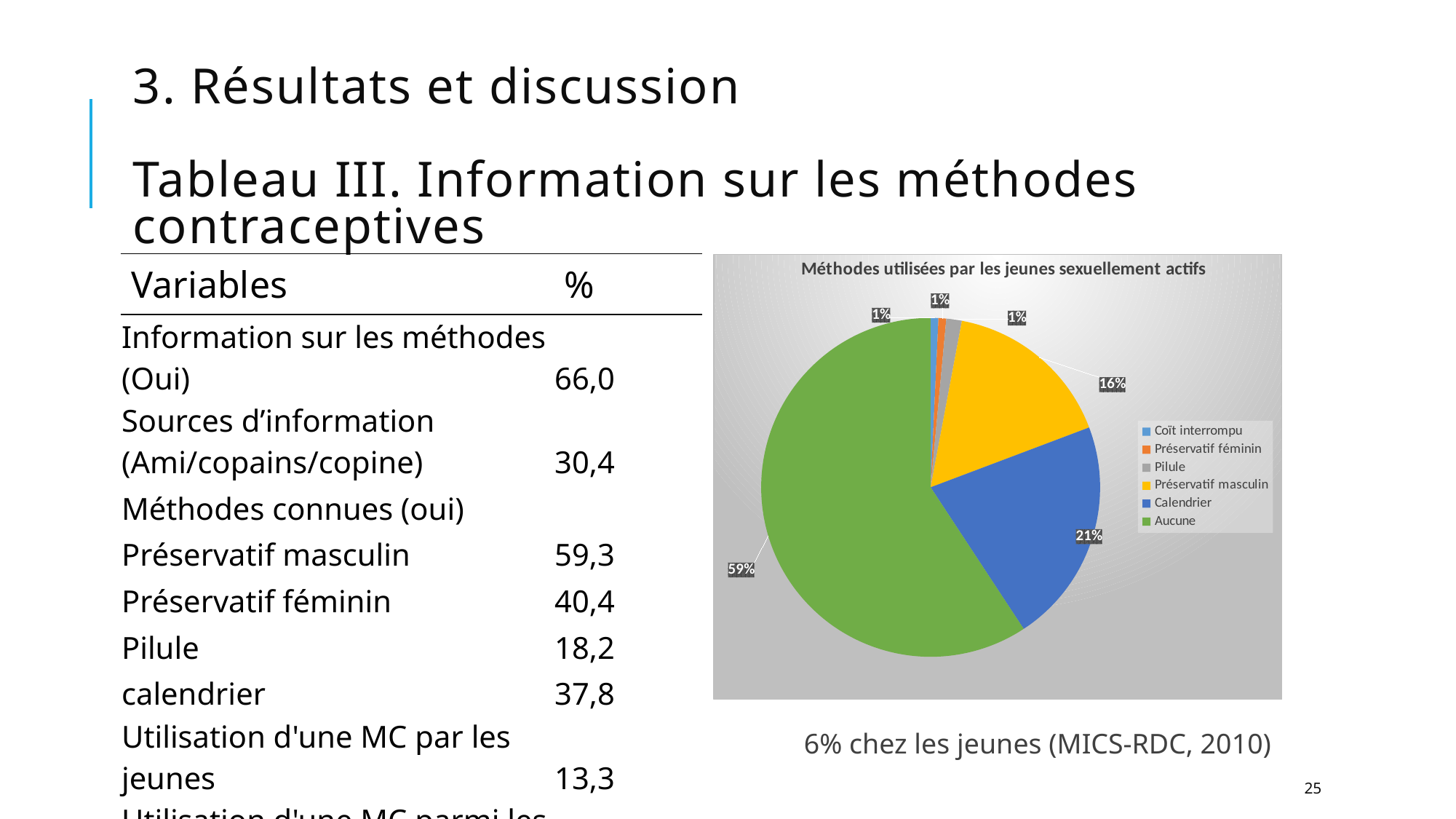
Which category has the largest slice of the pie? Aucune Which is larger, the Calendrier slice or the Préservatif masculin slice? Calendrier What share of the pie does Préservatif masculin represent? 16% What is the difference between the Calendrier share and the Préservatif masculin share? 5% What share of the pie does Pilule represent? 1% What share of the pie does Calendrier represent? 21% What is the difference between the Aucune share and the Calendrier share? 38% Which colour represents Aucune in the pie chart? Green What is the title of the pie chart? Méthodes utilisées par les jeunes sexuellement actifs What type of chart is shown on the slide? Pie chart How many categories does the legend of the pie chart list? 6